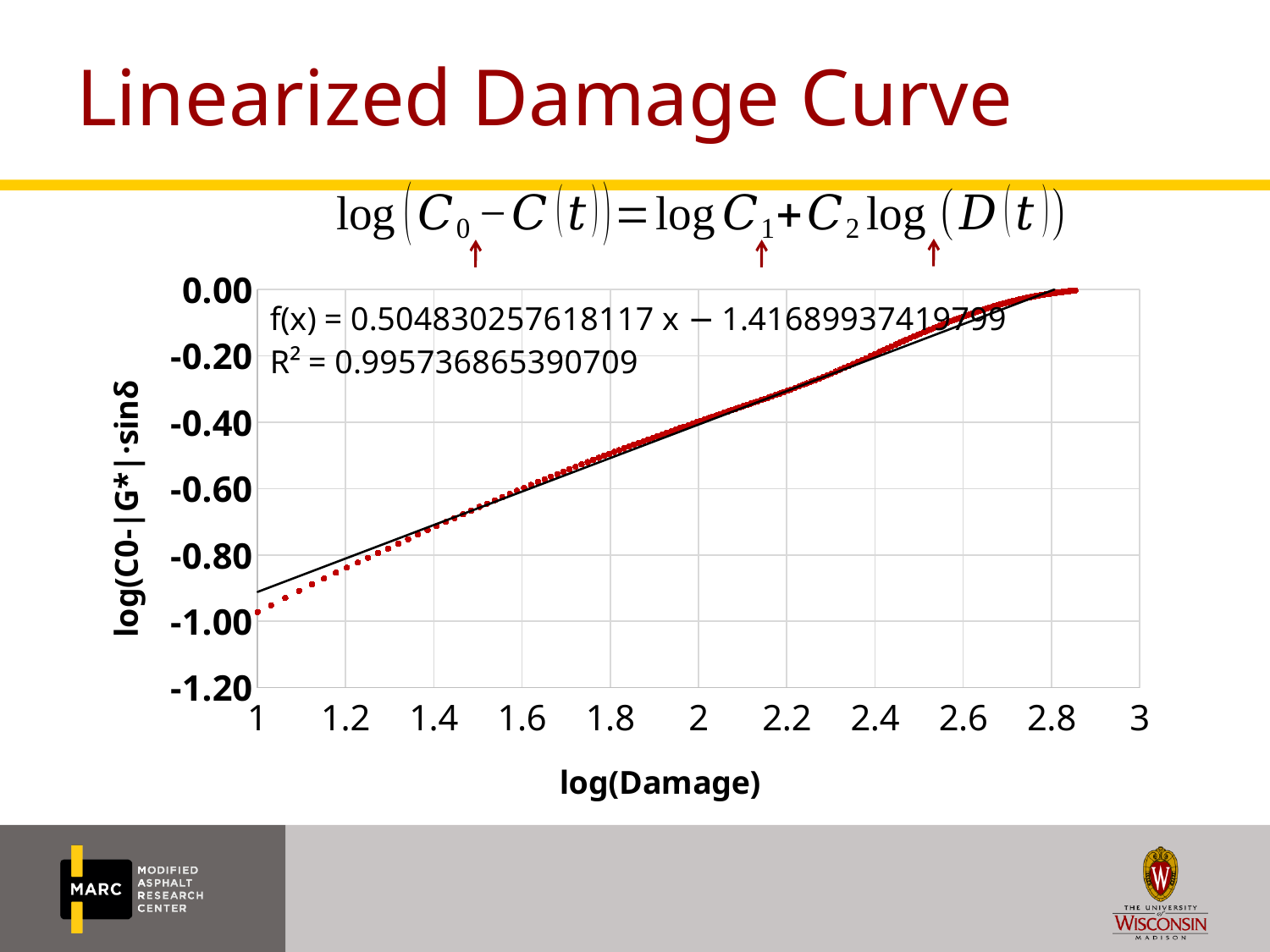
What kind of chart is shown on the slide? scatter chart Is the plotted value at log(Damage) = 2.6 greater or less than -0.20? greater Is the plotted value at log(Damage) = 1.6 greater or less than -0.80? greater What is the R² value printed on the chart? 0.995736865390709 Do the plotted values rise or fall as log(Damage) increases along the x axis? rise What is the title of the x axis of the chart? log(Damage) Is the plotted value at log(Damage) = 1.6 greater or less than -0.40? less